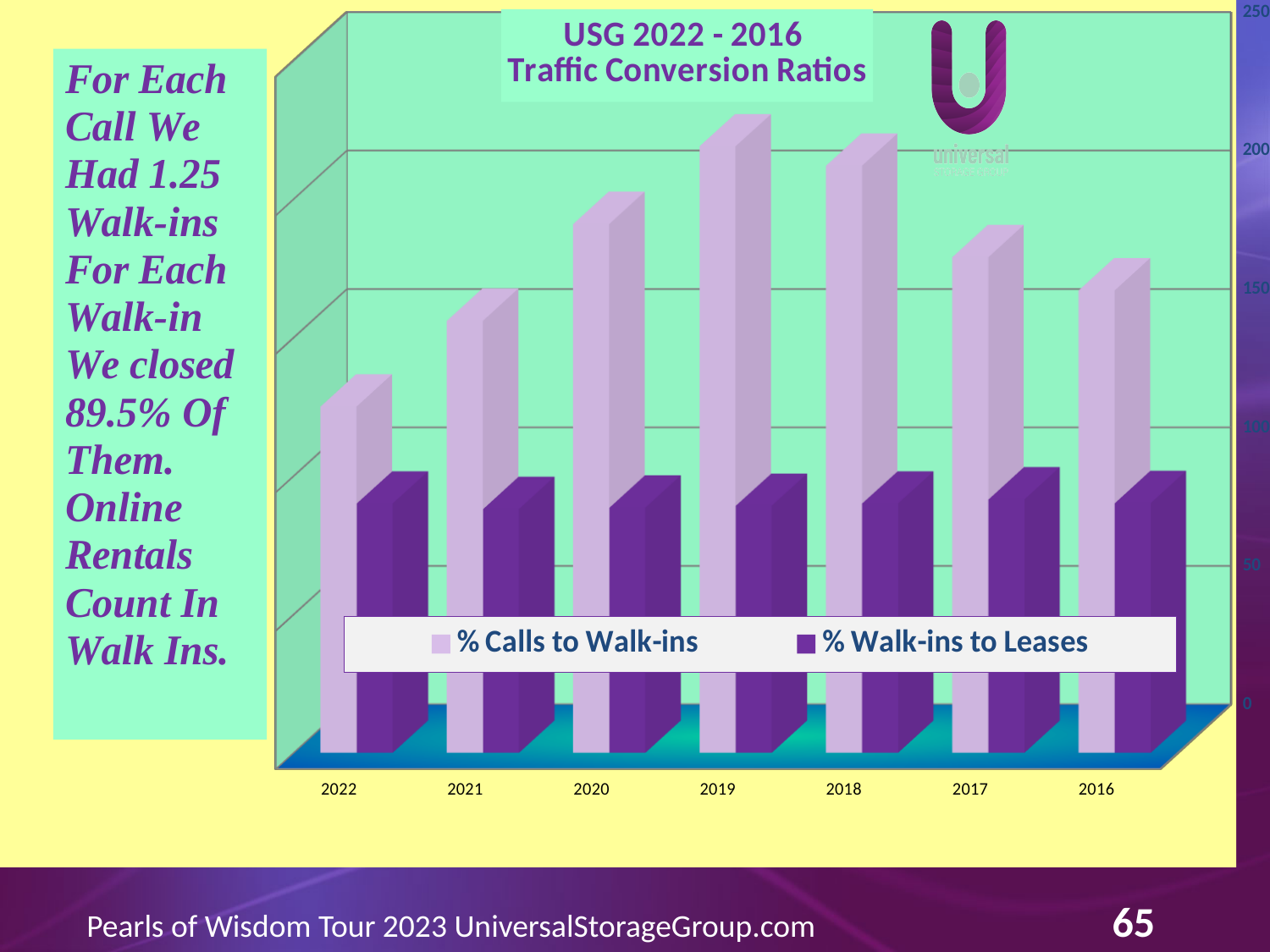
Does the % Calls to Walk-ins series rise or fall from 2019 to 2016 along the x axis? Fall Which series is shown in the darker purple bars? % Walk-ins to Leases What kind of chart is shown on the slide? Bar chart What is the title of the chart? USG 2022 - 2016 Traffic Conversion Ratios How many series does the legend list? 2 Which year has the lowest value for % Calls to Walk-ins? 2022 Which year has the highest value for % Calls to Walk-ins? 2019 How many years are shown on the x axis? 7 Is the % Walk-ins to Leases value for 2020 greater or less than 100? less Which is larger, the % Calls to Walk-ins value for 2020 or for 2021? 2020 Is the % Calls to Walk-ins value for 2022 greater or less than 150? less Is the % Calls to Walk-ins value for 2019 greater or less than 200? greater